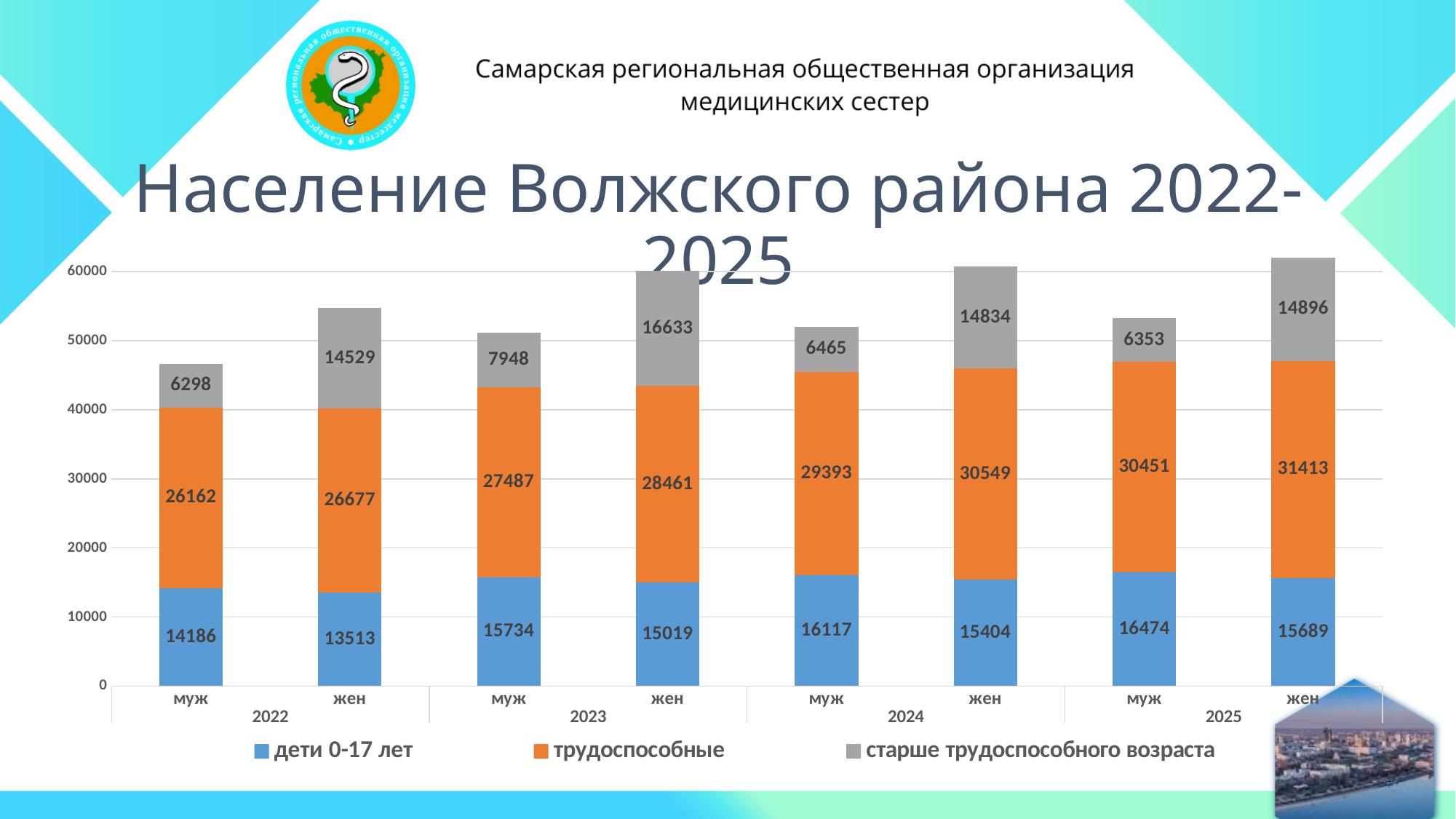
What is the difference between the трудоспособные values for муж and жен in 2024? 1156 What kind of chart is shown on the slide? Stacked bar chart What is the total of the stacked bar for муж in 2022? 46646 Do the дети 0-17 лет values for муж rise or fall from 2022 to 2025? Rise What is the value for дети 0-17 лет for муж in 2022? 14186 Which is larger: старше трудоспособного возраста for муж in 2023 or for муж in 2024? муж 2023 Which bar has the highest value for трудоспособные? жен 2025 What is the value for трудоспособные for жен in 2025? 31413 How many bars are shown in the chart? 8 Which bar has the lowest value for дети 0-17 лет? жен 2022 What is the value for старше трудоспособного возраста for жен in 2023? 16633 How many series does the legend list? 3